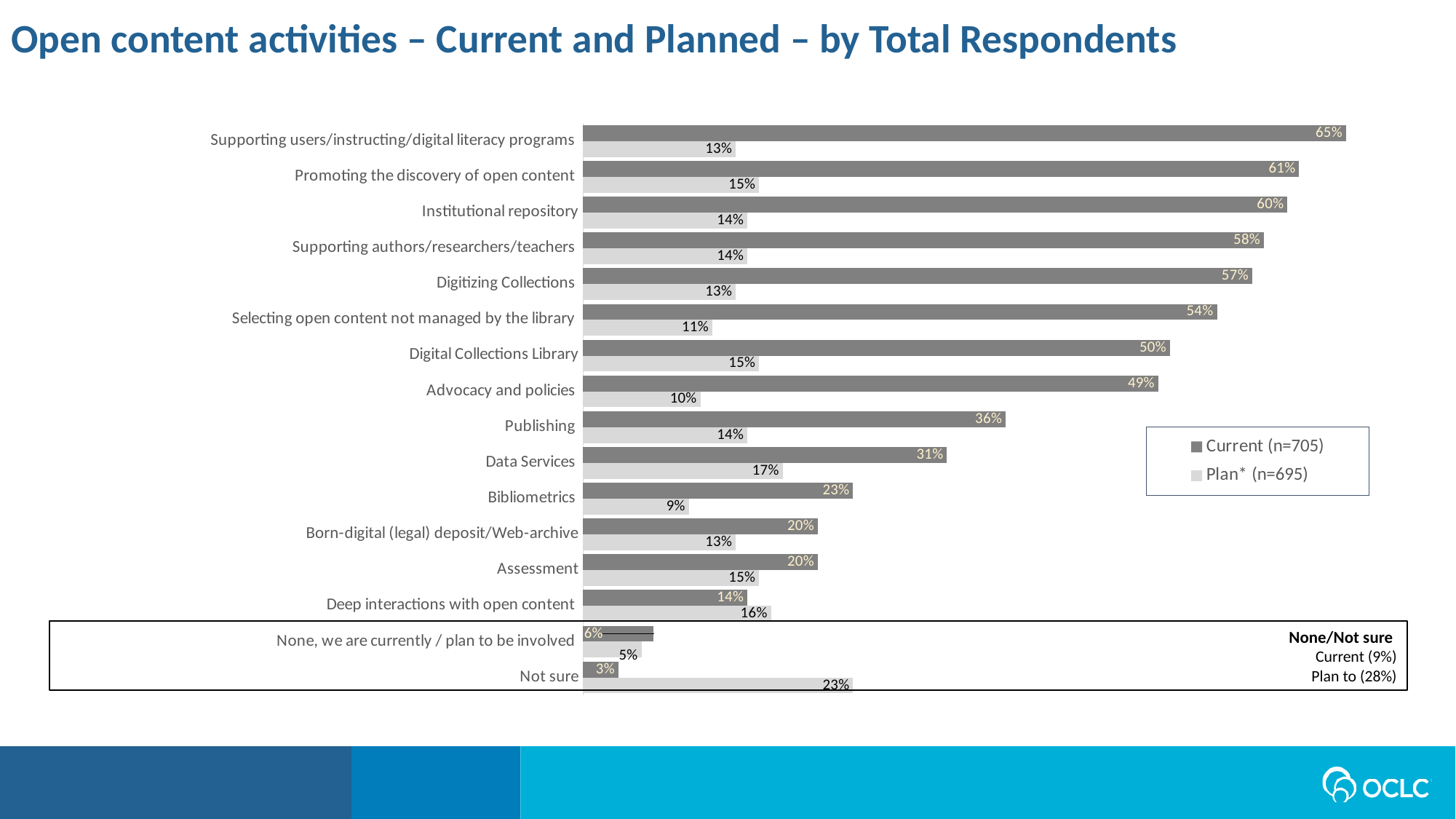
Which category has the lowest Plan value? None, we are currently / plan to be involved What is the Current value for Advocacy and policies? 49% How many series does the legend list? 2 Which activity has the highest Current value? Supporting users/instructing/digital literacy programs Which has a higher Current value, Bibliometrics or Data Services? Data Services What is the difference between the Current and Plan values for Publishing? 22% What is the Plan value for Not sure? 23% What is the Plan value for Data Services? 17% What kind of chart is shown on the slide? Bar chart Which is larger for Deep interactions with open content, the Current value or the Plan value? Plan What is the Current value for Institutional repository? 60% How many categories are shown on the chart? 16